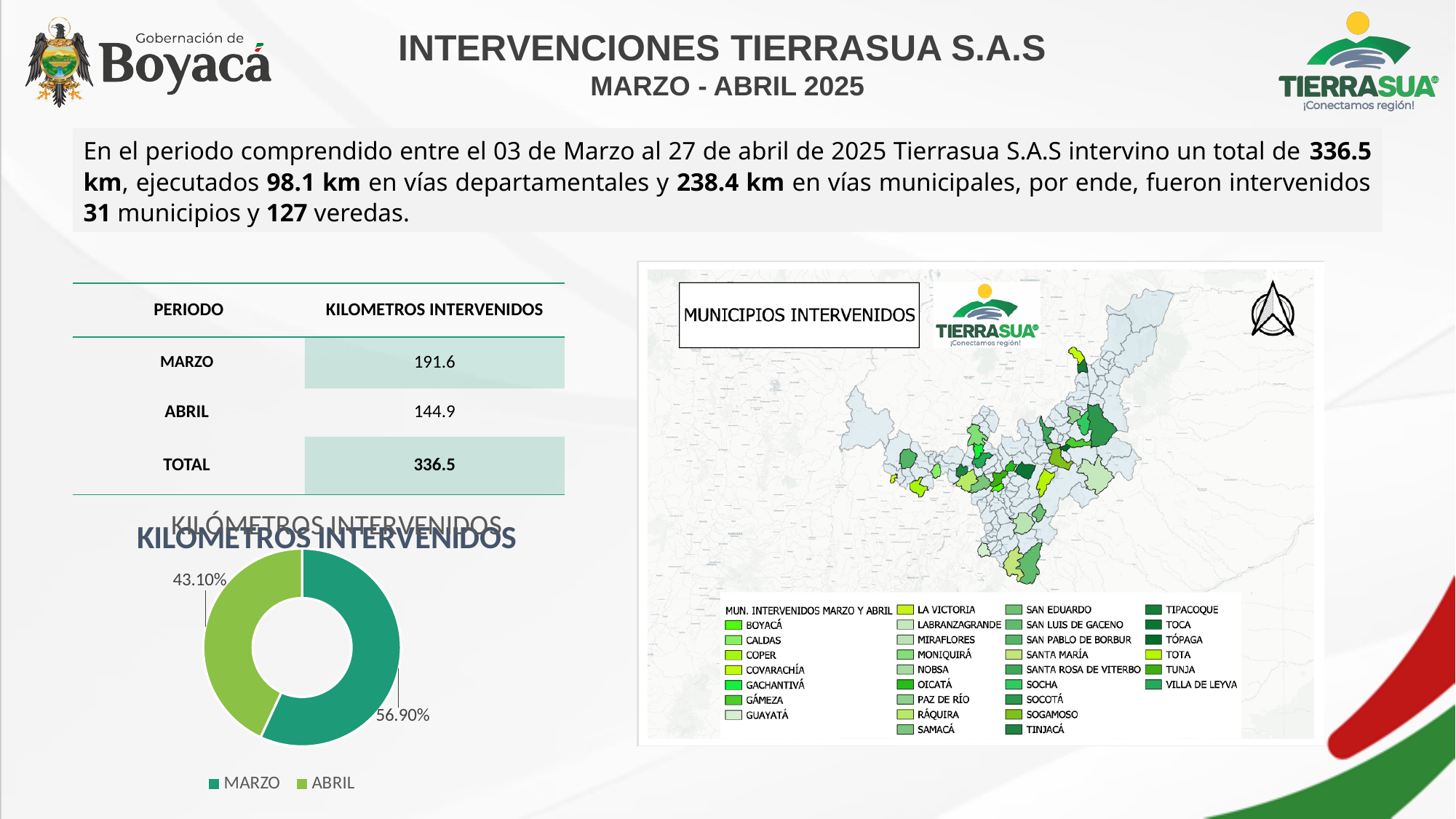
In the doughnut chart, which slice is larger, MARZO or ABRIL? MARZO In the doughnut chart, what share of the kilometres intervened corresponds to MARZO? 56.90% Is the MARZO share in the doughnut chart greater or less than 50%? greater Which period has the largest slice in the doughnut chart? MARZO Which period is shown in the light green colour in the doughnut chart? ABRIL How many slices does the doughnut chart have? 2 Which period has the smallest slice in the doughnut chart? ABRIL What is the difference in percentage points between the MARZO and ABRIL slices in the doughnut chart? 13.80% What kind of chart is used to show the kilometres intervened by period? Doughnut chart In the doughnut chart, what share of the kilometres intervened corresponds to ABRIL? 43.10% What is the title of the doughnut chart? KILÓMETROS INTERVENIDOS How many entries does the legend of the doughnut chart list? 2